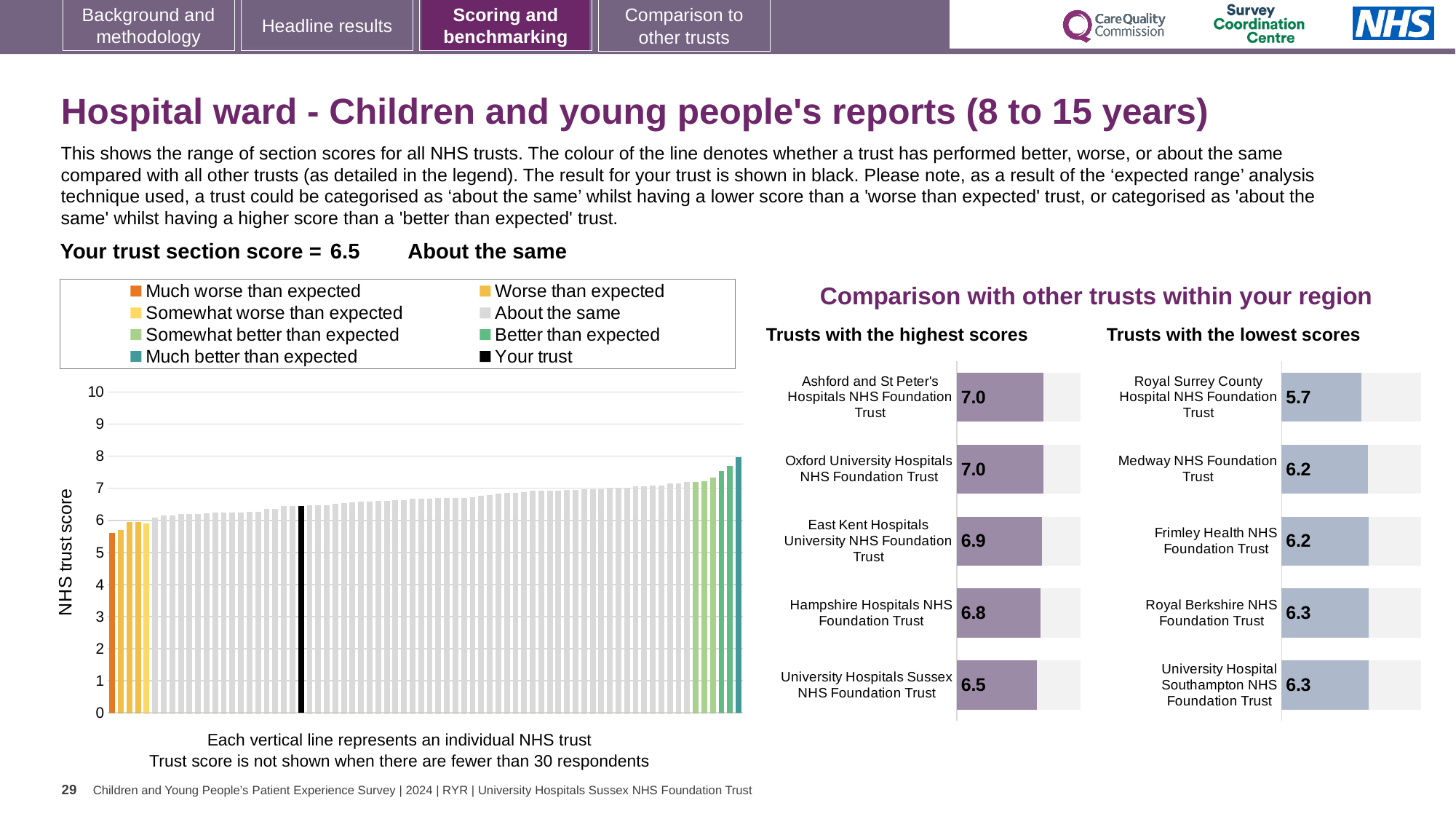
In the 'Trusts with the lowest scores' chart, what is the difference between the scores of Royal Berkshire NHS Foundation Trust and Royal Surrey County Hospital NHS Foundation Trust? 0.6 In the 'Trusts with the highest scores' chart, what is the score for Hampshire Hospitals NHS Foundation Trust? 6.8 In the 'Trusts with the lowest scores' chart, which trust has the lowest score? Royal Surrey County Hospital NHS Foundation Trust In the 'Trusts with the highest scores' chart, which trust has the lowest score? University Hospitals Sussex NHS Foundation Trust In the large chart on the left, is the value of the black bar (your trust) greater or less than 6? greater How many entries does the legend above the large chart on the left list? 8 How many trusts are shown in the 'Trusts with the highest scores' chart? 5 In the 'Trusts with the highest scores' chart, which has the higher score: East Kent Hospitals University NHS Foundation Trust or Hampshire Hospitals NHS Foundation Trust? East Kent Hospitals University NHS Foundation Trust In the 'Trusts with the highest scores' chart, what is the difference between the scores of Ashford and St Peter's Hospitals NHS Foundation Trust and University Hospitals Sussex NHS Foundation Trust? 0.5 What kind of chart is the large chart on the left showing NHS trust scores? Bar chart In the 'Trusts with the lowest scores' chart, what is the score for Medway NHS Foundation Trust? 6.2 In the 'Trusts with the highest scores' chart, what is the score for Ashford and St Peter's Hospitals NHS Foundation Trust? 7.0